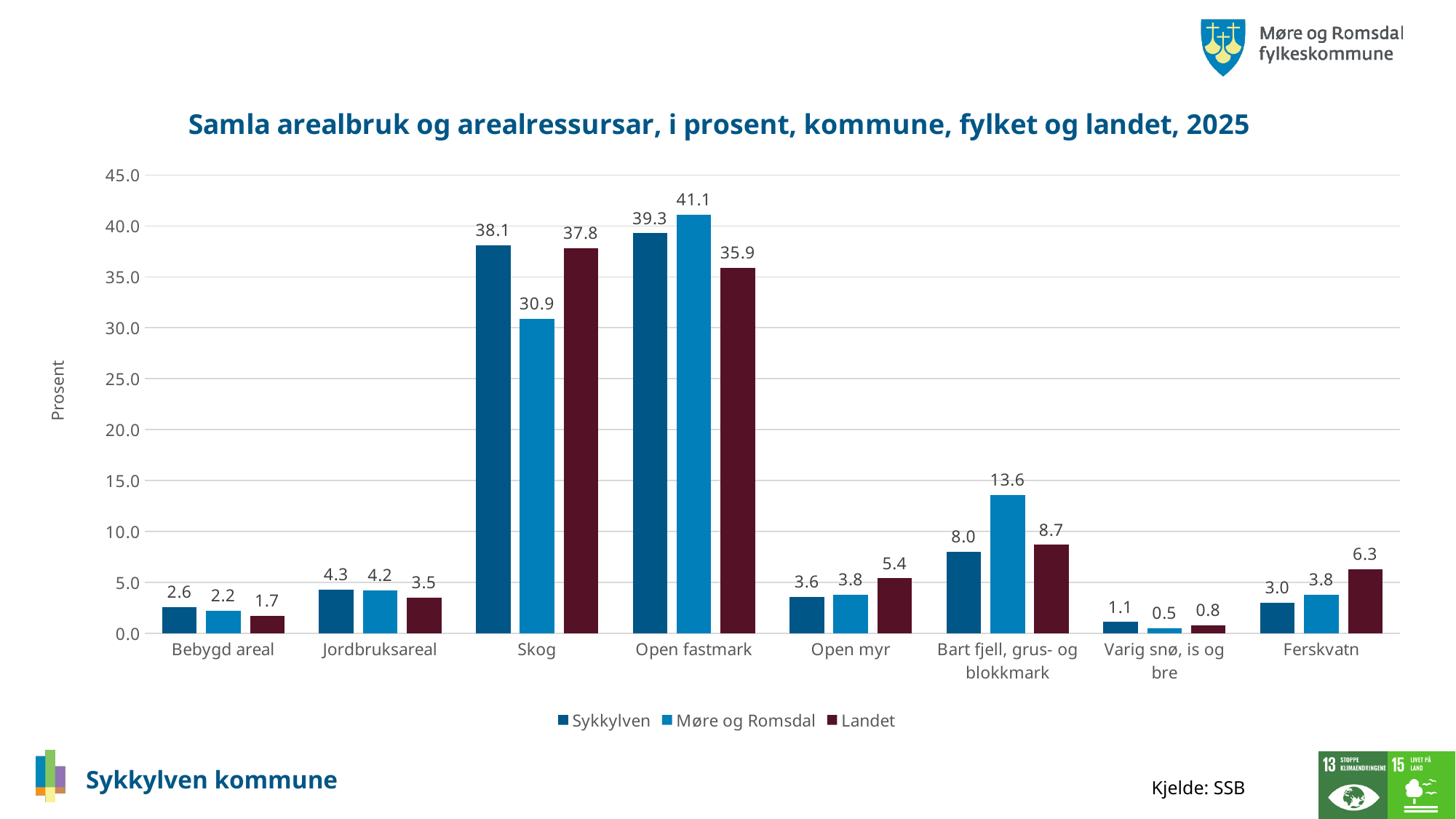
In the Skog category, which is larger: the value for Sykkylven or the value for Møre og Romsdal? Sykkylven What is the value for Møre og Romsdal in the Open fastmark category? 41.1 How many series does the legend list? 3 What is the value for Landet in the Ferskvatn category? 6.3 Is the value for Landet in the Open fastmark category greater or less than 40.0? less What is the value for Sykkylven in the Skog category? 38.1 Which category has the highest value for Sykkylven? Open fastmark Which category has the lowest value for Møre og Romsdal? Varig snø, is og bre What is the label of the y axis? Prosent How many categories are shown on the x axis? 8 What kind of chart is shown on the slide? bar chart What is the difference between the Møre og Romsdal and Landet values in the Bart fjell, grus- og blokkmark category? 4.9